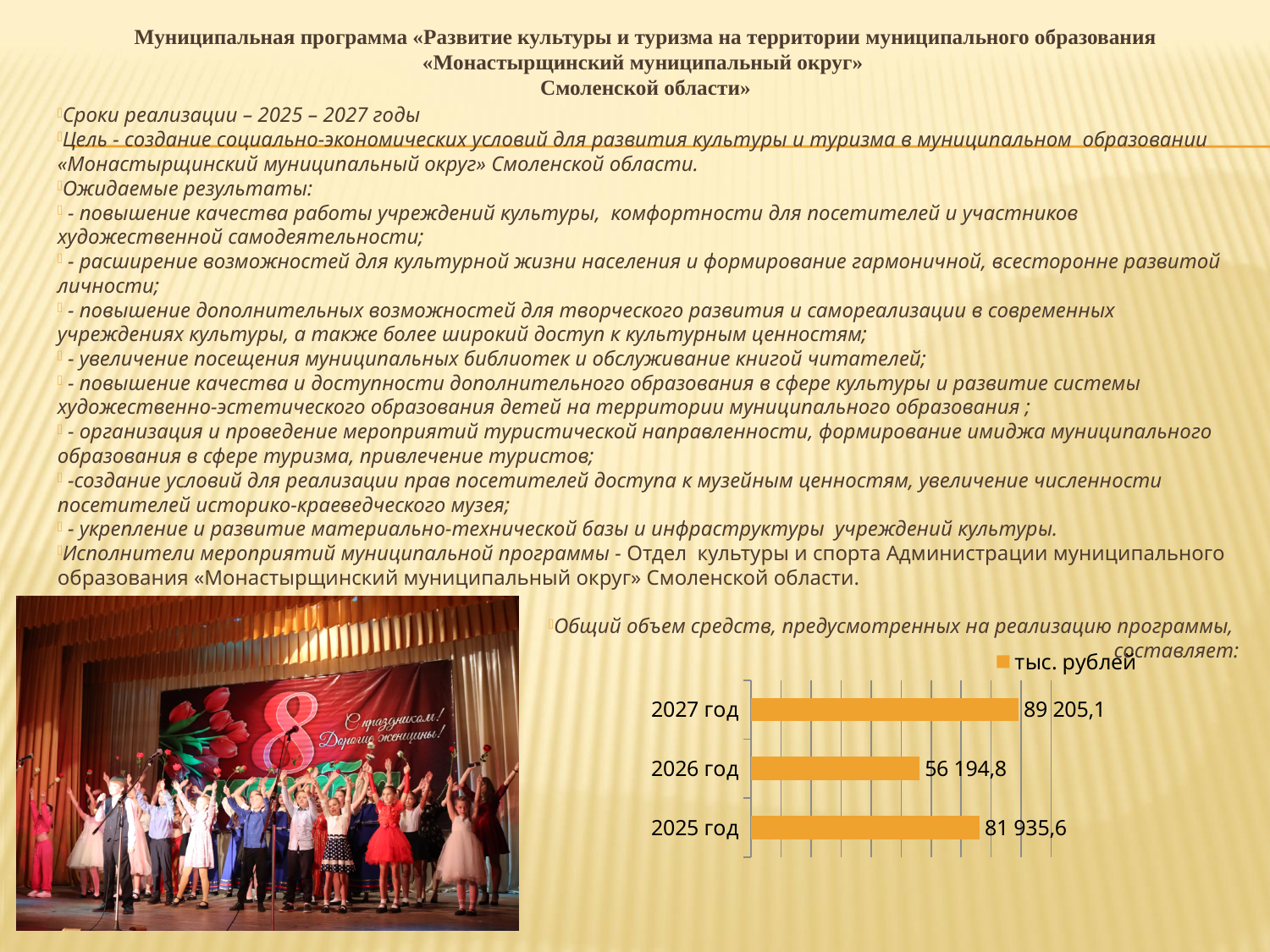
What is the value for 2025 год? 81 935,6 What is the difference between the values for 2027 год and 2026 год? 33 010,3 What is the difference between the values for 2027 год and 2025 год? 7 269,5 What is the value for 2026 год? 56 194,8 Which year has the lowest value? 2026 год How many years are shown in the chart? 3 What series name does the chart legend show? тыс. рублей What is the difference between the values for 2025 год and 2026 год? 25 740,8 What kind of chart is shown on the slide? bar chart What is the value for 2027 год? 89 205,1 Which is larger, the value for 2025 год or the value for 2026 год? 2025 год Which year has the highest value? 2027 год